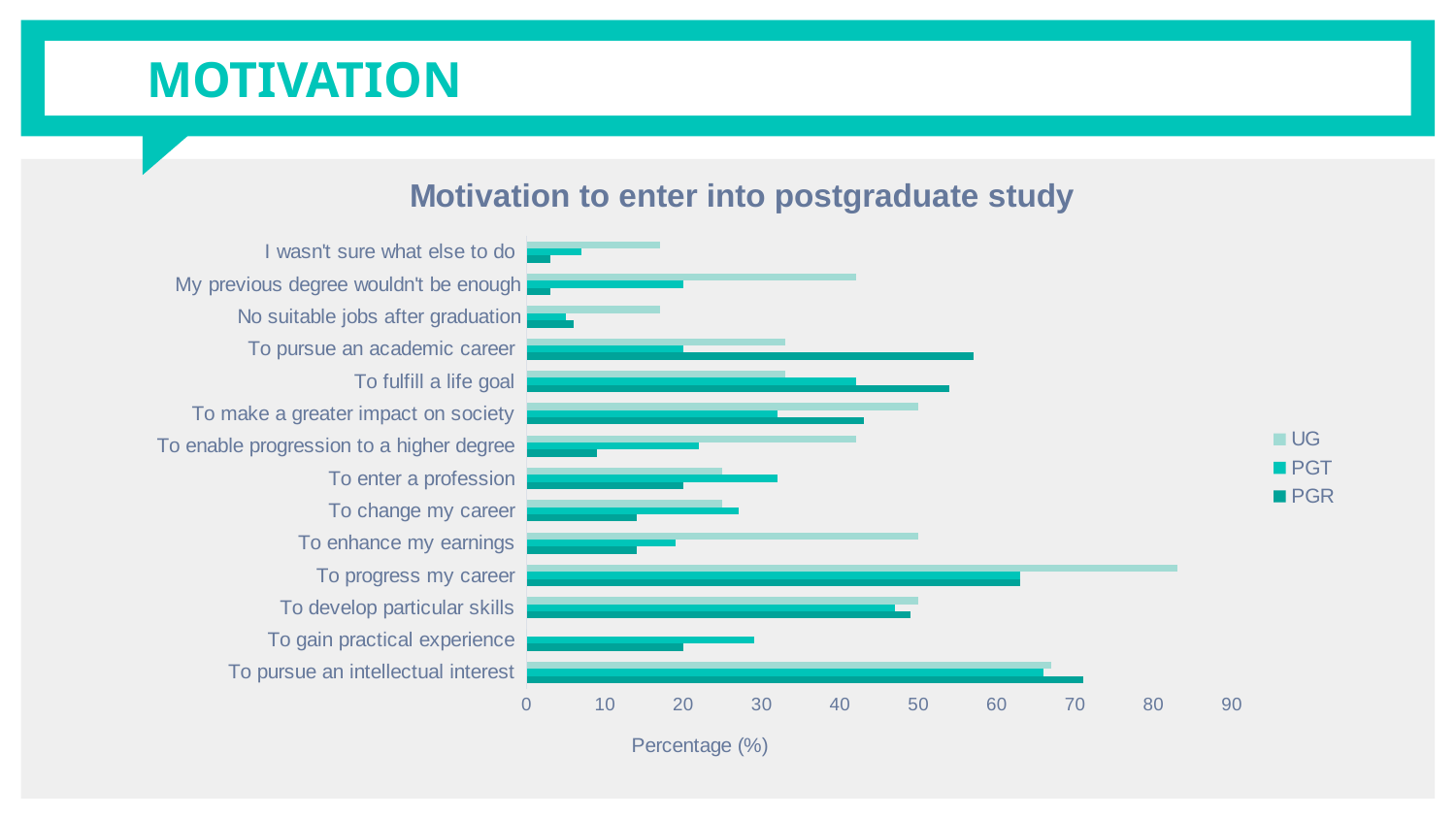
Is the PGR value for 'To pursue an academic career' greater or less than 50? greater Which motivation has the highest PGR value? To pursue an intellectual interest How many motivation categories are plotted on the chart? 14 How many series does the legend list? 3 Is the PGT value for 'My previous degree wouldn't be enough' greater or less than 30? less What is the title of the chart? Motivation to enter into postgraduate study Which motivation has the highest UG value? To progress my career For 'To enhance my earnings', which series has the larger value, UG or PGT? UG Is the UG value for 'To progress my career' greater or less than 70? greater What is the label on the horizontal axis of the chart? Percentage (%) For 'To pursue an academic career', which series has the larger value, UG or PGR? PGR What kind of chart is shown on the slide? Bar chart